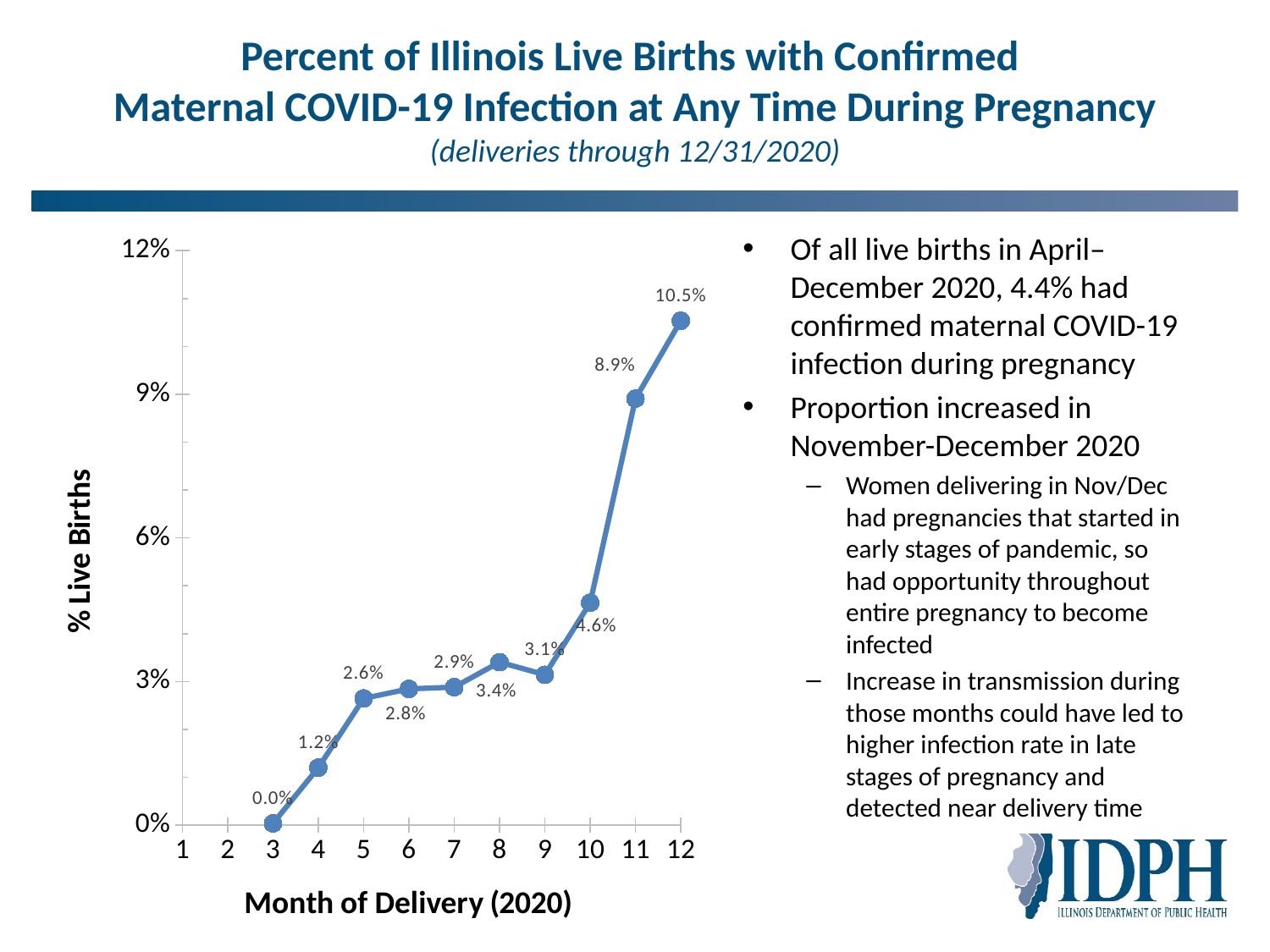
How many data points are plotted on the line? 10 What is the value plotted for month 3? 0.0% Which has the larger value, month 8 or month 9? Month 8 Which month of delivery has the lowest plotted value? 3 Is the value for month 10 greater or less than 3%? greater What is the label of the y axis? % Live Births What kind of chart is shown on the slide? Line chart What is the percent of live births with confirmed maternal COVID-19 infection for month 12? 10.5% What is the value plotted for month 11? 8.9% Which month of delivery has the highest percent of live births with confirmed maternal COVID-19 infection? 12 What is the difference between the values for month 12 and month 11? 1.6% What is the value plotted for month 5? 2.6%